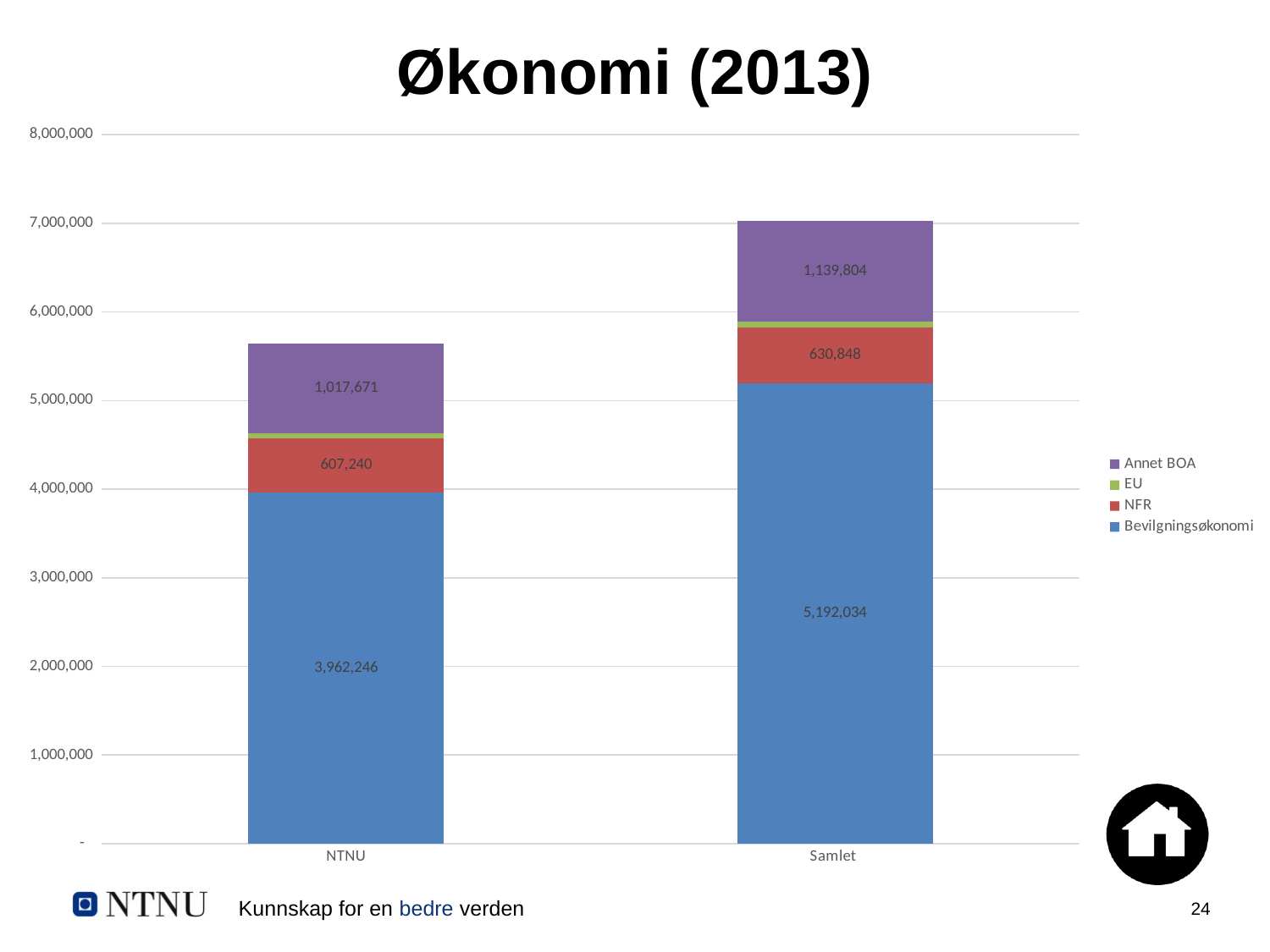
Which category has the larger NFR value, NTNU or Samlet? Samlet How many series does the legend list? 4 What is the Bevilgningsøkonomi value for Samlet? 5,192,034 What is the Bevilgningsøkonomi value for NTNU? 3,962,246 What type of chart is shown on the slide? Stacked bar chart How many categories are shown on the x axis? 2 What is the difference between the Bevilgningsøkonomi values for Samlet and NTNU? 1,229,788 Is the total height of the NTNU bar greater or less than 5,000,000? greater What is the difference between the Annet BOA values for Samlet and NTNU? 122,133 Which series is shown in purple in the legend? Annet BOA What is the Annet BOA value for Samlet? 1,139,804 What is the NFR value for NTNU? 607,240